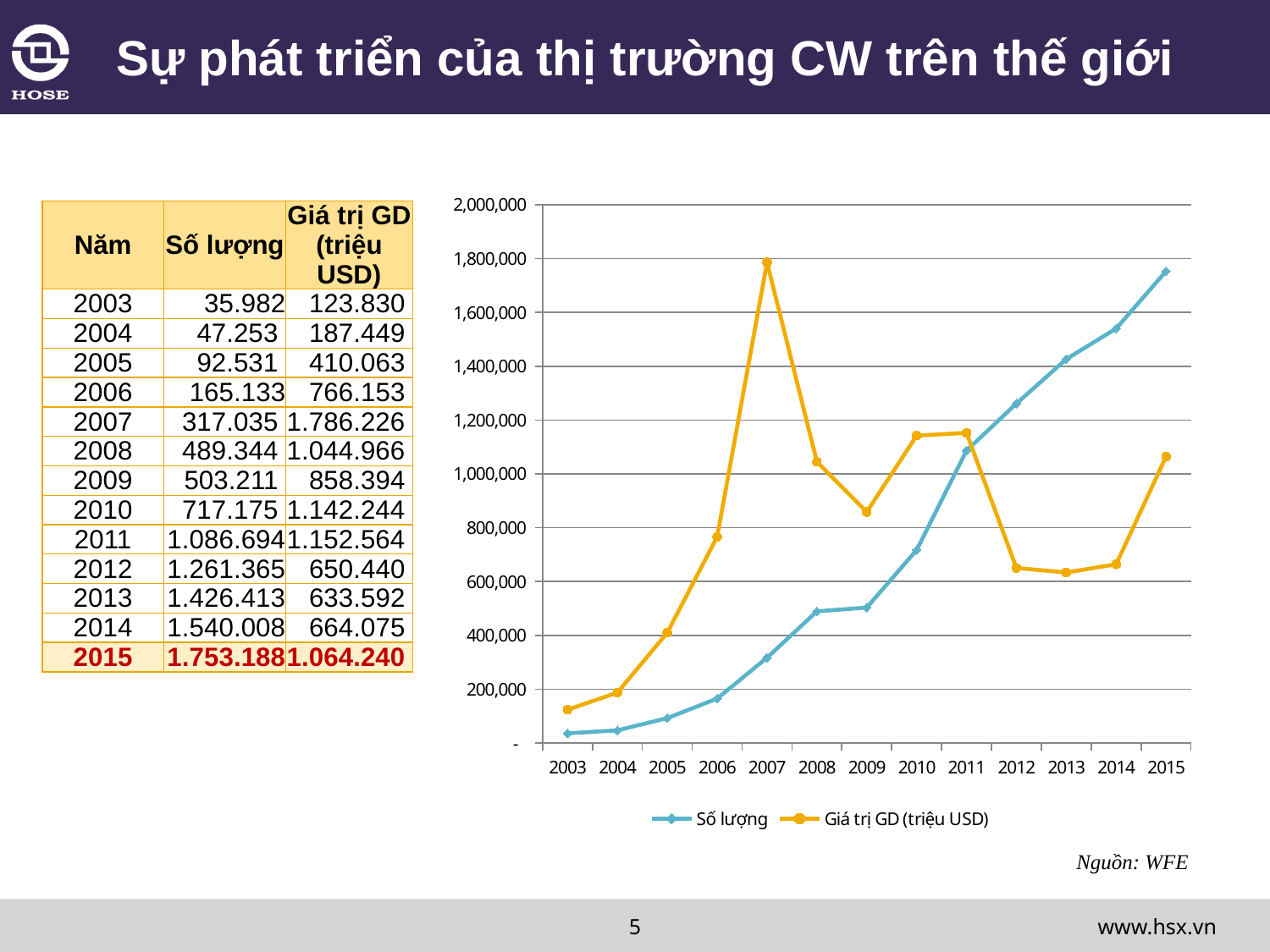
What type of chart is shown on the slide? line chart Is the value of Số lượng in 2015 greater or less than 1,600,000? greater In 2007, which series has the higher value, Số lượng or Giá trị GD (triệu USD)? Giá trị GD (triệu USD) Which colour is used for the Số lượng series in the chart? blue In which year is the Số lượng series at its lowest? 2003 Does the Số lượng series rise or fall from 2003 to 2015? rise In 2012, which series has the higher value, Số lượng or Giá trị GD (triệu USD)? Số lượng Is the value of Giá trị GD (triệu USD) in 2013 greater or less than 800,000? less How many series does the chart legend list? 2 In which year does the Giá trị GD (triệu USD) series reach its highest value? 2007 How many years are plotted along the x axis of the chart? 13 According to the table on the slide, what is the Số lượng value for 2015? 1.753.188